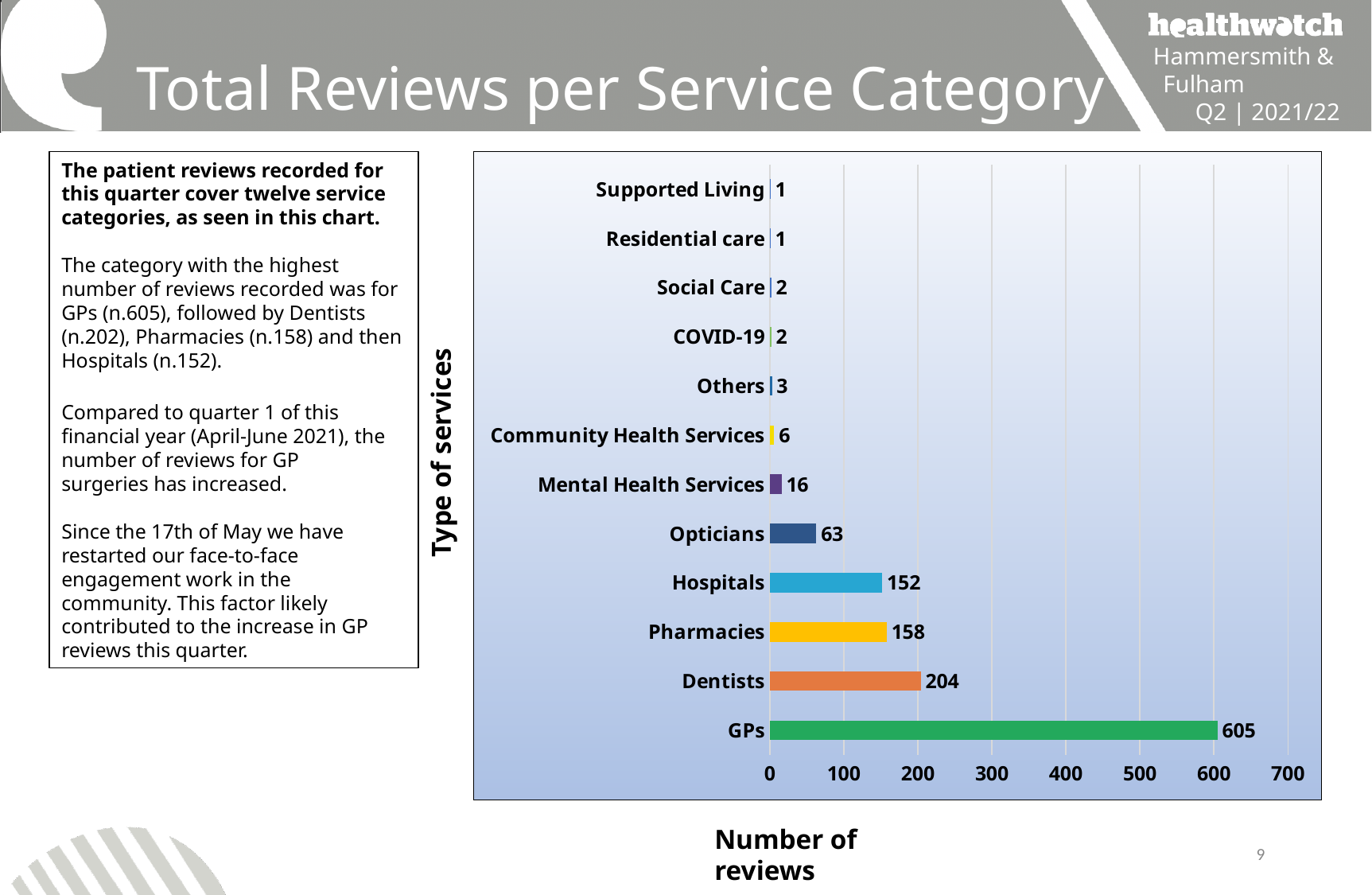
What is the label of the horizontal axis? Number of reviews What is the difference in reviews between GPs and Dentists? 401 What kind of chart is shown on the slide? Bar chart Which has more reviews, Opticians or Mental Health Services? Opticians What is the number of reviews for Community Health Services? 6 Is the value for GPs greater or less than 500? greater How many service categories are shown in the chart? 12 What is the difference in reviews between Dentists and Hospitals? 52 What is the number of reviews for GPs? 605 What is the number of reviews for Pharmacies? 158 Which service category has the highest number of reviews? GPs What is the number of reviews for Mental Health Services? 16